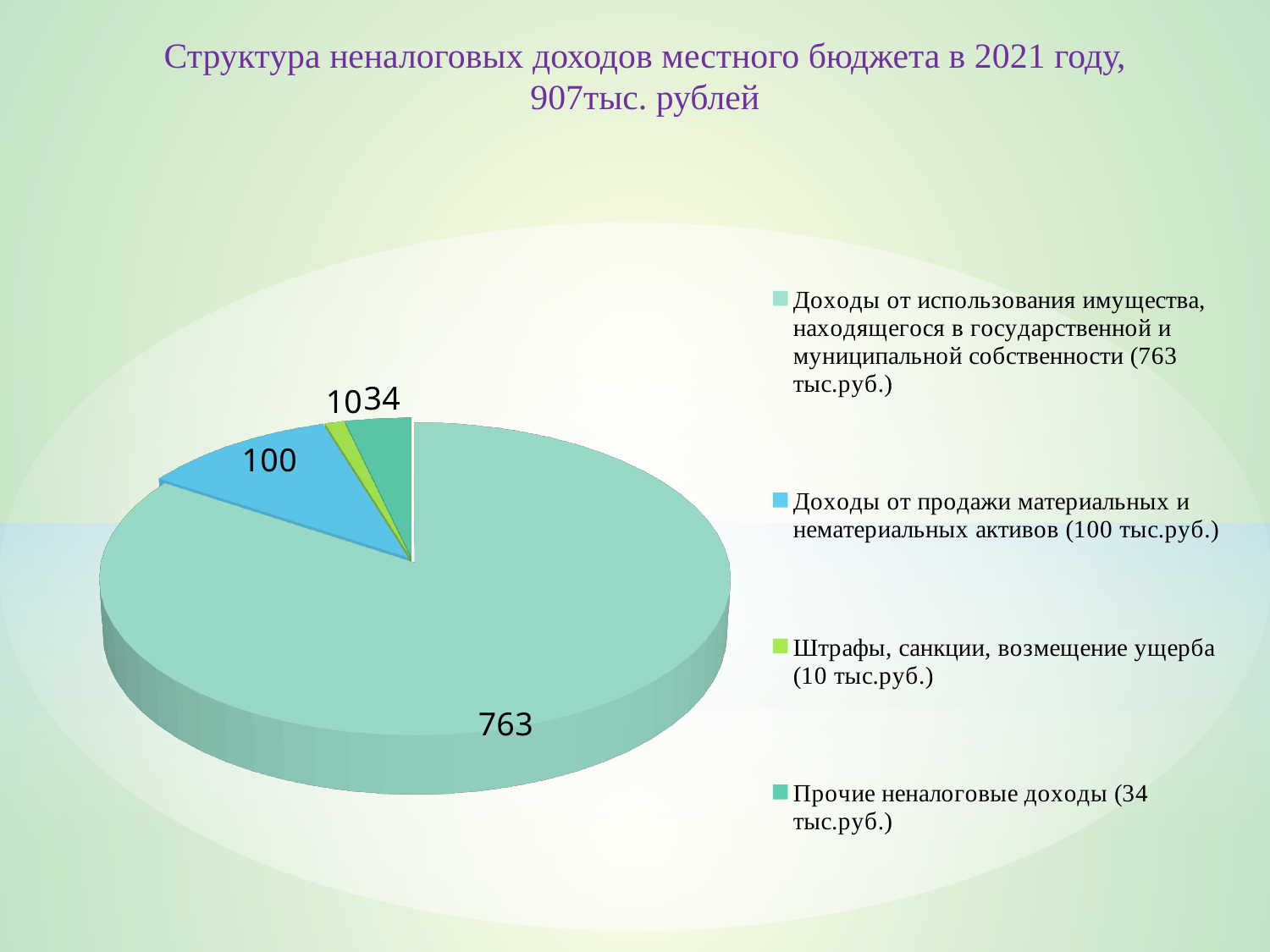
What is the title of the chart? Структура неналоговых доходов местного бюджета в 2021 году, 907тыс. рублей What is the total of all slices in the pie chart? 907 What is the value for "Доходы от использования имущества, находящегося в государственной и муниципальной собственности"? 763 Which is larger: "Прочие неналоговые доходы" or "Штрафы, санкции, возмещение ущерба"? Прочие неналоговые доходы What is the value for "Прочие неналоговые доходы"? 34 How many slices does the pie chart have? 4 Which category has the largest slice of the pie? Доходы от использования имущества, находящегося в государственной и муниципальной собственности What is the difference between the value for "Доходы от использования имущества" and the value for "Доходы от продажи материальных и нематериальных активов"? 663 Which category has the smallest slice of the pie? Штрафы, санкции, возмещение ущерба What type of chart is shown on the slide? Pie chart What is the value for "Доходы от продажи материальных и нематериальных активов"? 100 What is the value for "Штрафы, санкции, возмещение ущерба"? 10